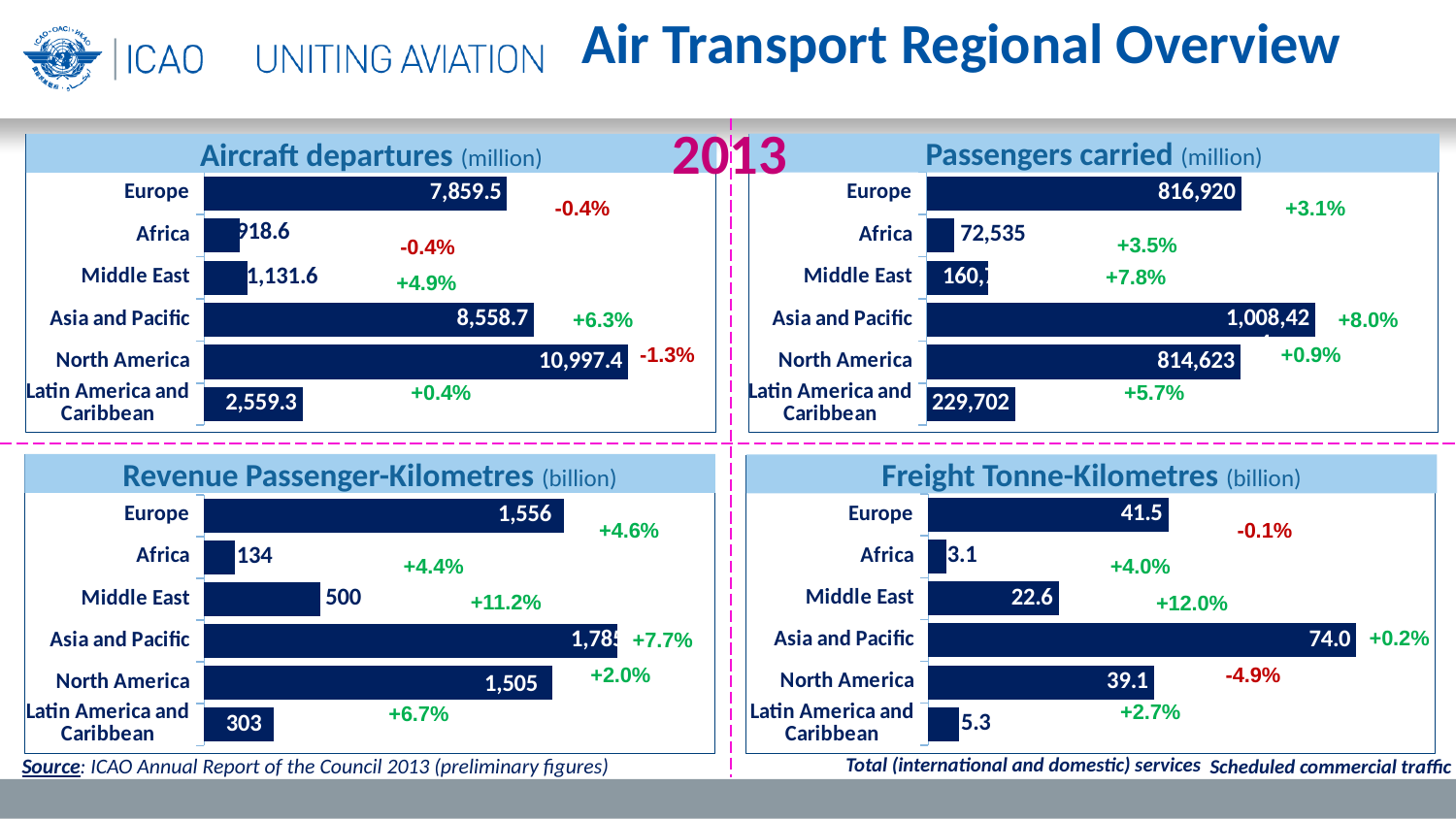
How many regions are shown in the Freight Tonne-Kilometres chart? 6 In the Revenue Passenger-Kilometres chart, what is the difference between Europe and North America? 51 In the Freight Tonne-Kilometres chart, what is the value for Middle East? 22.6 In the Passengers carried chart, which is larger, Europe or North America? Europe In the Aircraft departures chart, which region has the highest value? North America In the Passengers carried chart, which region has the lowest value? Africa What kind of chart is the Revenue Passenger-Kilometres chart? Bar chart In the Passengers carried chart, what is the value for Latin America and Caribbean? 229,702 In the Aircraft departures chart, what is the value for North America? 10,997.4 In the Revenue Passenger-Kilometres chart, what is the value for Middle East? 500 In the Freight Tonne-Kilometres chart, which region has the highest value? Asia and Pacific In the Aircraft departures chart, what is the difference between Asia and Pacific and Europe? 699.2